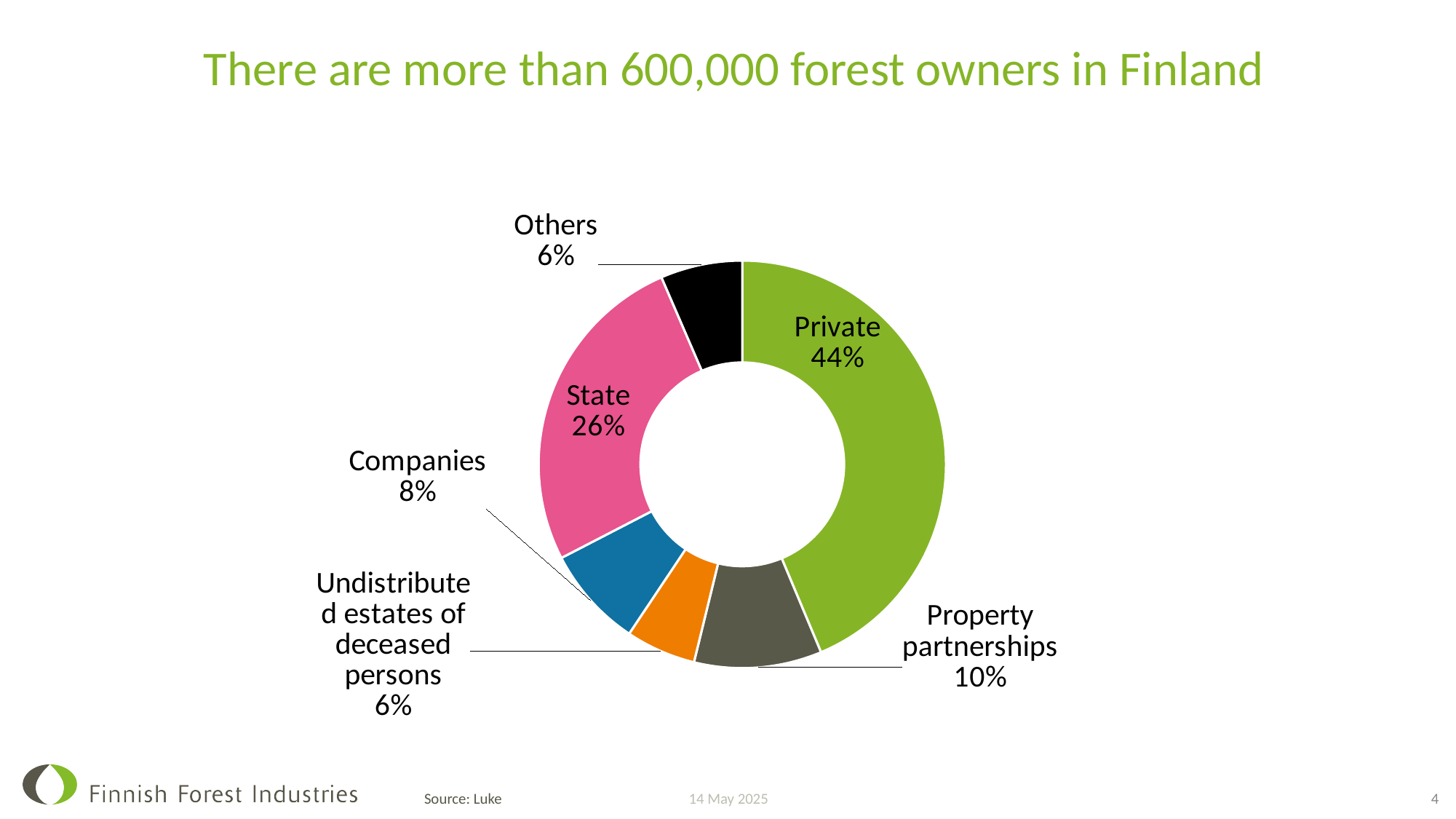
What share of forest owners is Property partnerships? 10% What share of forest owners is Private? 44% Which category has the largest share of forest owners? Private What is the title of the slide? There are more than 600,000 forest owners in Finland Which is larger, the share for Companies or the share for Property partnerships? Property partnerships How many categories are shown in the chart? 6 What share of forest owners is Companies? 8% What kind of chart is shown on the slide? Doughnut (pie) chart What share of forest owners is the State? 26% What is the combined share of Others and Undistributed estates of deceased persons? 12% What is the difference in percentage points between the Private and State shares? 18 What colour is the Private slice? Green